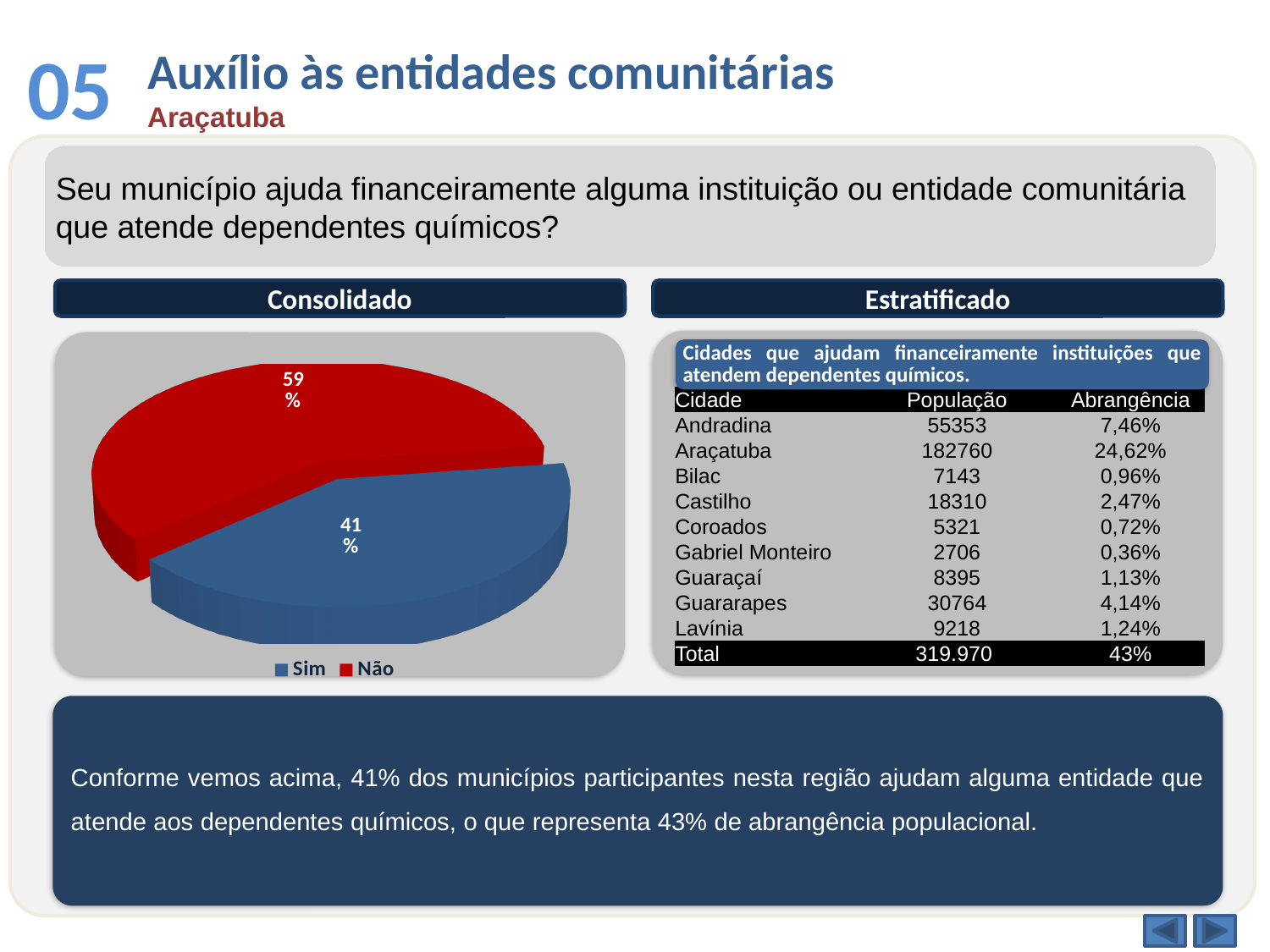
In the pie chart, which is larger, "Sim" or "Não"? Não What is the difference between the "Não" and "Sim" values in the pie chart? 18% What type of chart is shown under "Consolidado"? pie chart How many entries does the pie chart legend list? 2 What colour is the "Sim" slice in the pie chart? blue In the pie chart, what is the value for "Não"? 59% In the pie chart, what is the value for "Sim"? 41% Which slice of the pie chart is the largest? Não What colour is the "Não" slice in the pie chart? red How many slices does the pie chart have? 2 What share of the pie does the "Sim" slice represent? 41% Which slice of the pie chart is the smallest? Sim